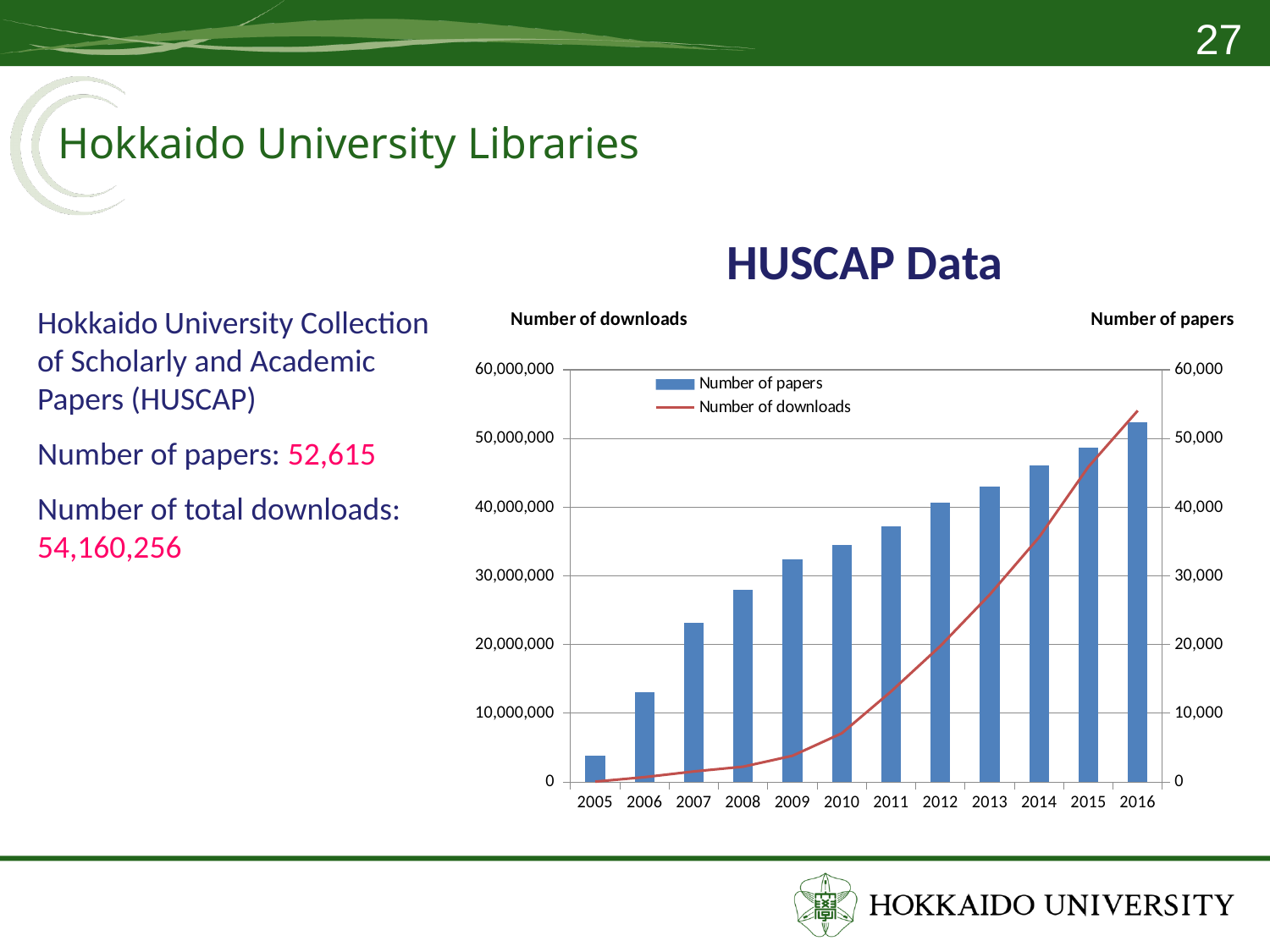
Is the number of papers for 2016 greater or less than 50,000? greater Is the number of papers for 2005 greater or less than 10,000? less Is the number of downloads for 2016 greater or less than 50,000,000? greater Which year has the lowest number of papers in the HUSCAP Data chart? 2005 What kind of chart is the HUSCAP Data chart? A bar chart combined with a line Do the number of downloads rise or fall from 2005 to 2016 in the HUSCAP Data chart? Rise How many years are shown on the x axis of the HUSCAP Data chart? 12 Which year has the larger number of papers, 2007 or 2010? 2010 How many series does the legend of the HUSCAP Data chart list? 2 Which year has the highest number of papers in the HUSCAP Data chart? 2016 Which series in the HUSCAP Data chart is drawn as a red line? Number of downloads